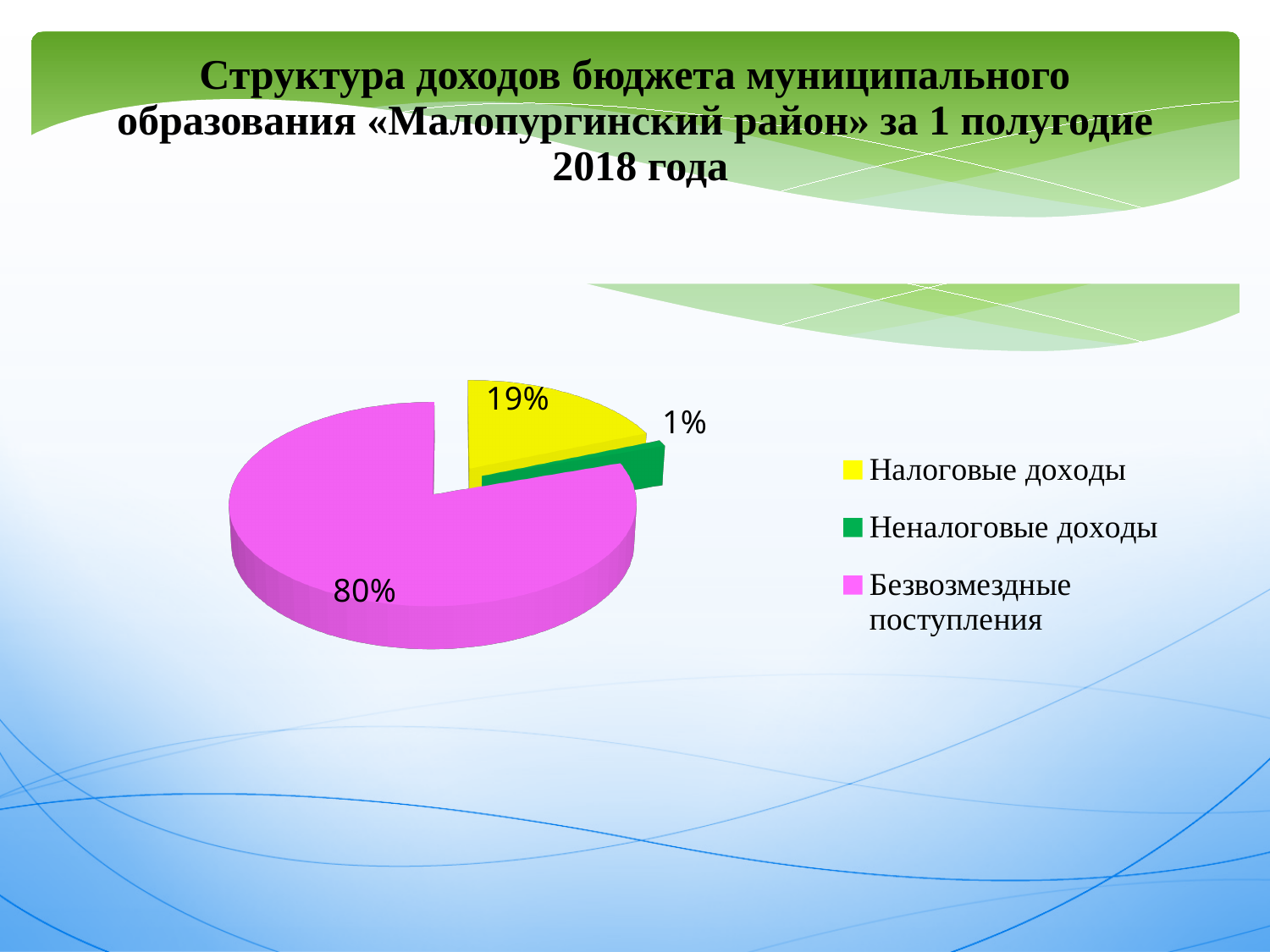
What is the combined share of Налоговые доходы and Неналоговые доходы? 20% Which category has the smallest share of the pie? Неналоговые доходы How many categories are shown in the pie chart? 3 What is the difference in percentage points between Безвозмездные поступления and Налоговые доходы? 61 What share of the pie does Налоговые доходы represent? 19% Which is larger: the share of Налоговые доходы or the share of Неналоговые доходы? Налоговые доходы What colour is the slice for Налоговые доходы? Yellow What colour is the slice for Безвозмездные поступления? Pink What share of the pie does Неналоговые доходы represent? 1% What share of the pie does Безвозмездные поступления represent? 80% Which category has the largest share of the pie? Безвозмездные поступления What kind of chart is shown on the slide? Pie chart